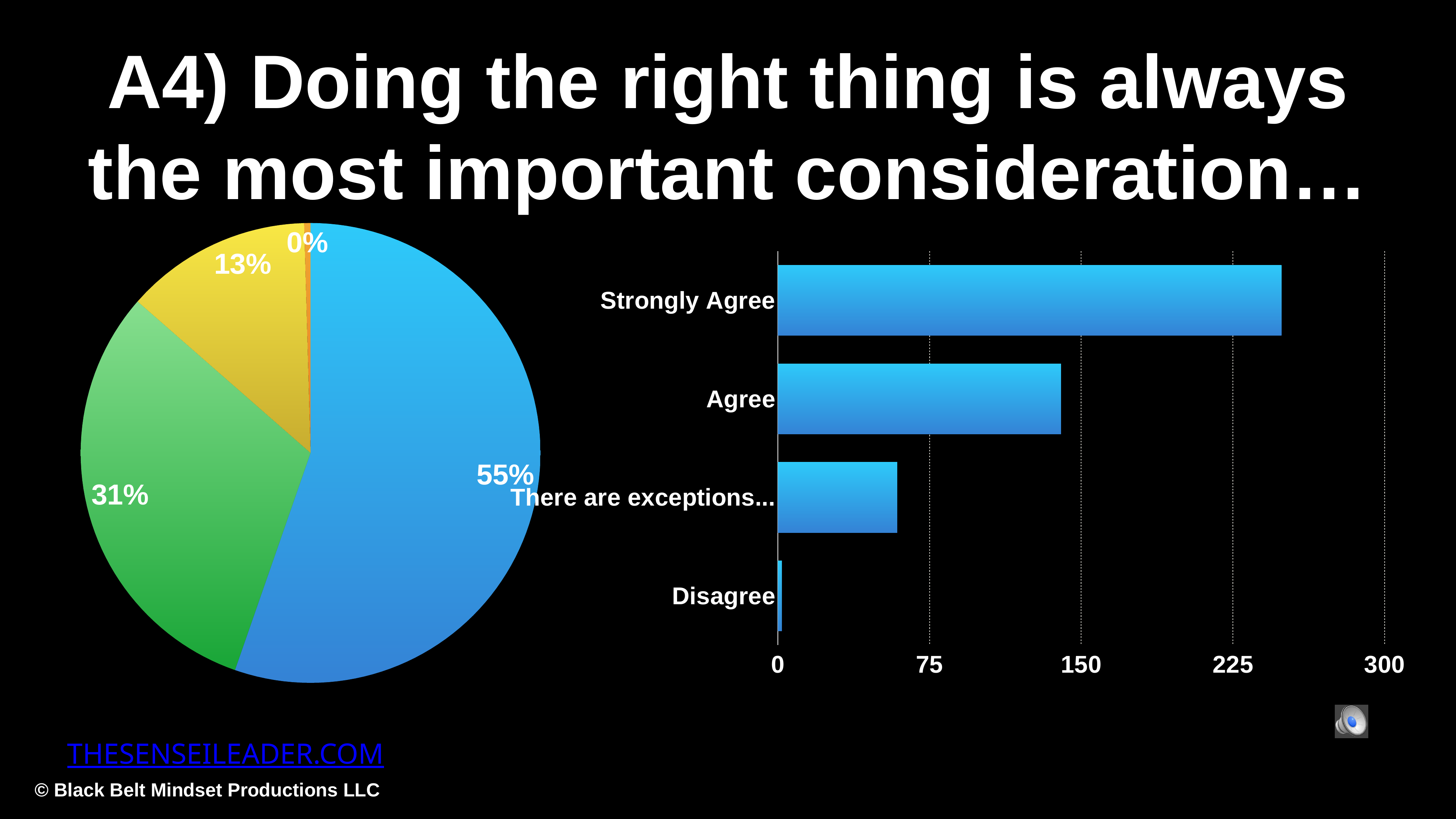
In the bar chart on the right, which category has the lowest value? Disagree In the bar chart on the right, which is larger, the value for Agree or the value for There are exceptions...? Agree In the bar chart on the right, is the value for There are exceptions... greater or less than 75? less How many slices does the pie chart on the left have? 4 In the pie chart on the left, what is the largest slice's share? 55% In the bar chart on the right, is the value for Strongly Agree greater or less than 225? greater In the pie chart on the left, what is the smallest slice's share? 0% In the bar chart on the right, is the value for Agree greater or less than 150? less What kind of chart is the chart on the left of the slide? pie chart What kind of chart is the chart on the right of the slide? bar chart In the bar chart on the right, which category has the highest value? Strongly Agree In the pie chart on the left, what is the difference between the largest slice (55%) and the green slice (31%)? 24%